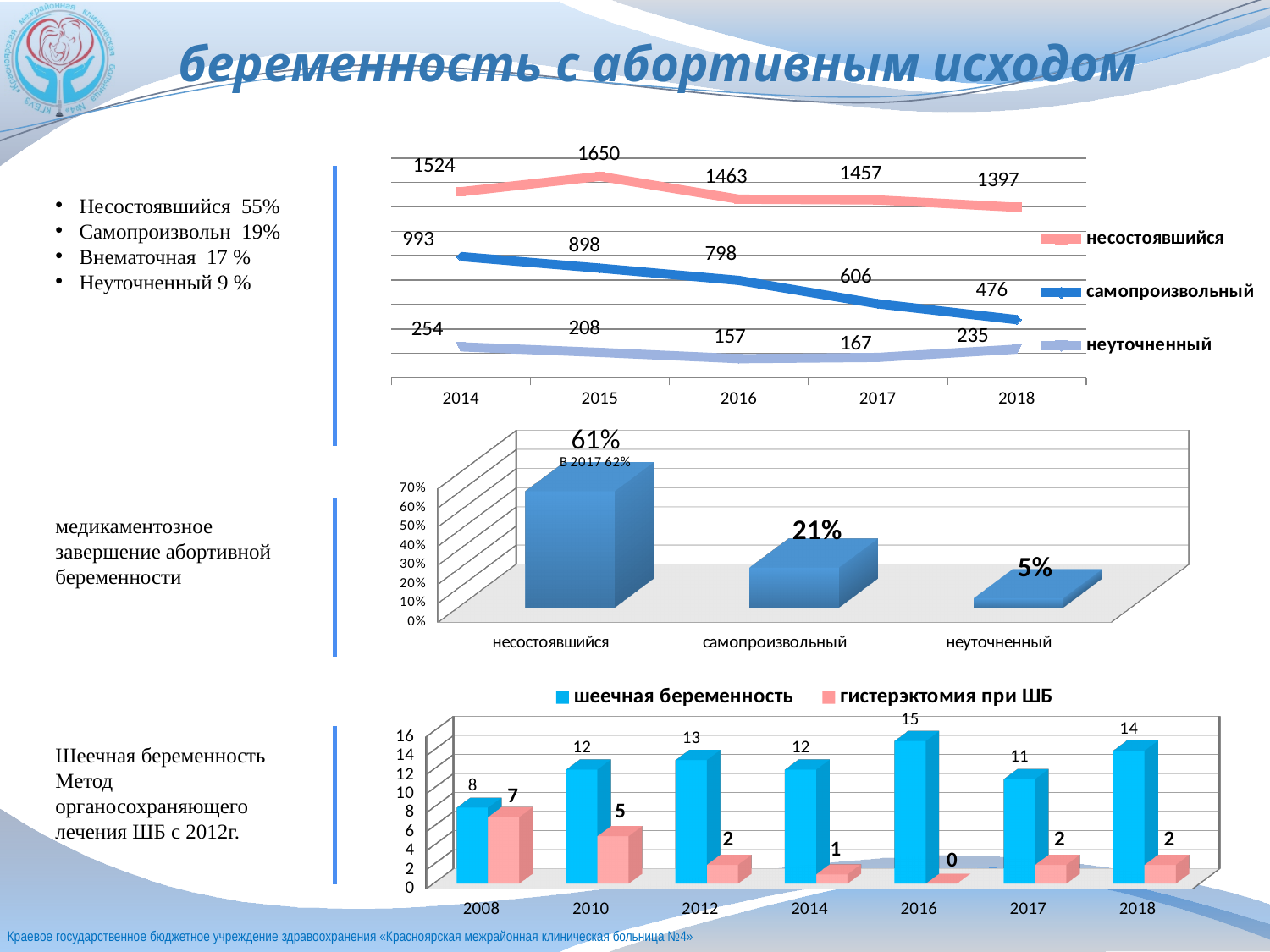
In the top line chart, what is the value for неуточненный in 2017? 167 In the top line chart, what is the value for самопроизвольный in 2016? 798 In the middle bar chart (медикаментозное завершение абортивной беременности), what is the value for самопроизвольный? 21% What kind of chart is the bottom chart (шеечная беременность)? bar chart In the bottom bar chart, what is the value for шеечная беременность in 2016? 15 In the top line chart, in which year is the несостоявшийся series highest? 2015 How many series does the legend of the top line chart list? 3 In the bottom bar chart, what is the difference between шеечная беременность and гистерэктомия при ШБ in 2010? 7 How many years are shown on the x axis of the bottom bar chart? 7 In the middle bar chart, which category has the lowest value? неуточненный In the top line chart, what is the difference between the несостоявшийся values in 2014 and 2018? 127 In the top line chart, does the самопроизвольный series rise or fall from 2014 to 2018? fall